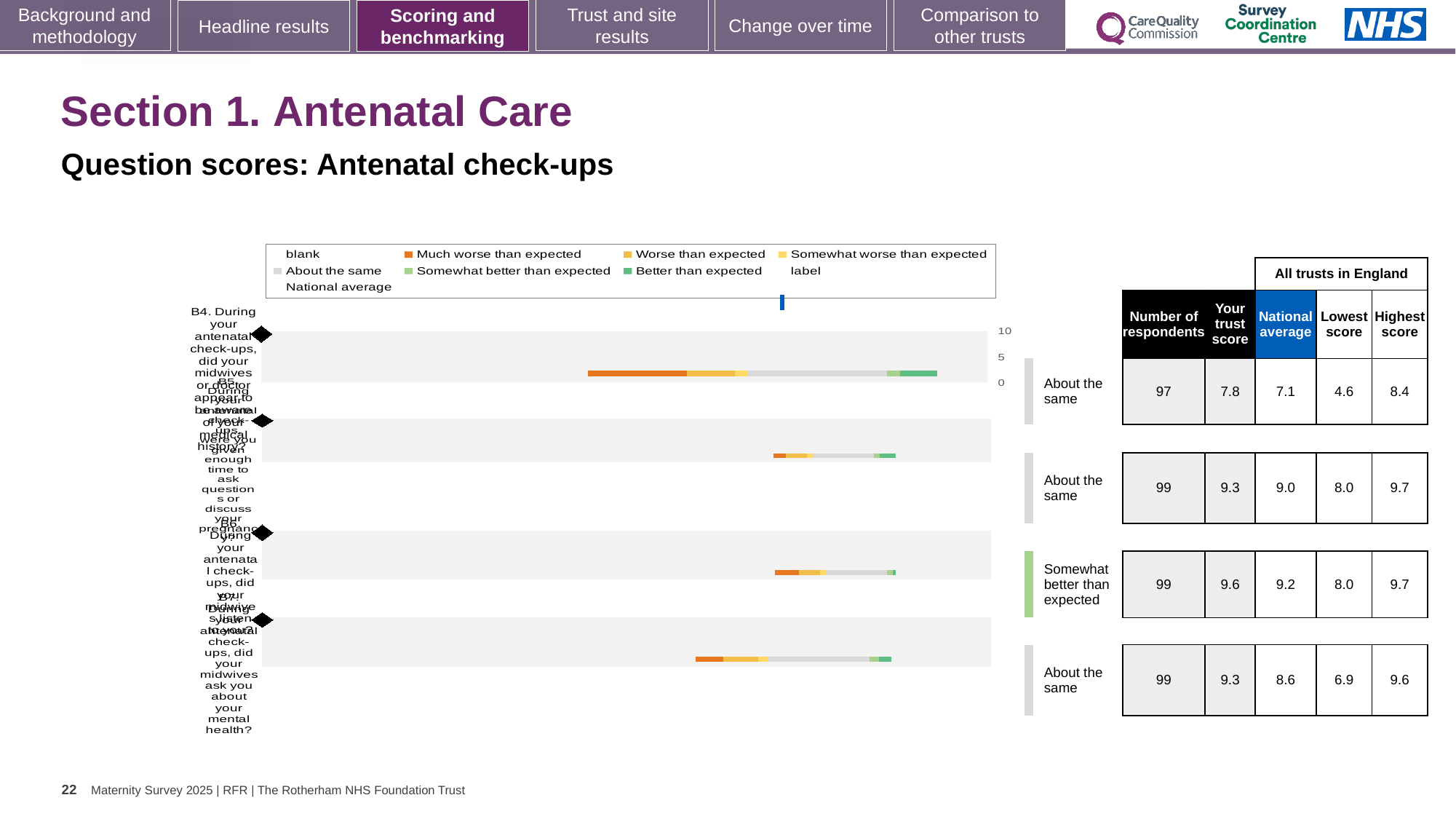
How many question bars are plotted in the chart? 4 For the first question, what is the difference between the trust score (7.8) and the national average (7.1)? 0.7 What kind of chart is shown on the slide? bar chart How many of the four questions are rated "About the same"? 3 What colour does the legend use for "Much worse than expected"? orange What benchmark rating is shown for the third question? Somewhat better than expected In the table beside the chart, what is the trust score for the third question? 9.6 Which of the four questions has the highest trust score in the table? the third question (9.6) For the fourth question, which is larger: the trust score or the national average? the trust score (9.3) What is the subtitle above the chart? Question scores: Antenatal check-ups What is the lowest value in the "Lowest score" column of the table? 4.6 In the table beside the chart, what is the number of respondents for the first (top) question? 97